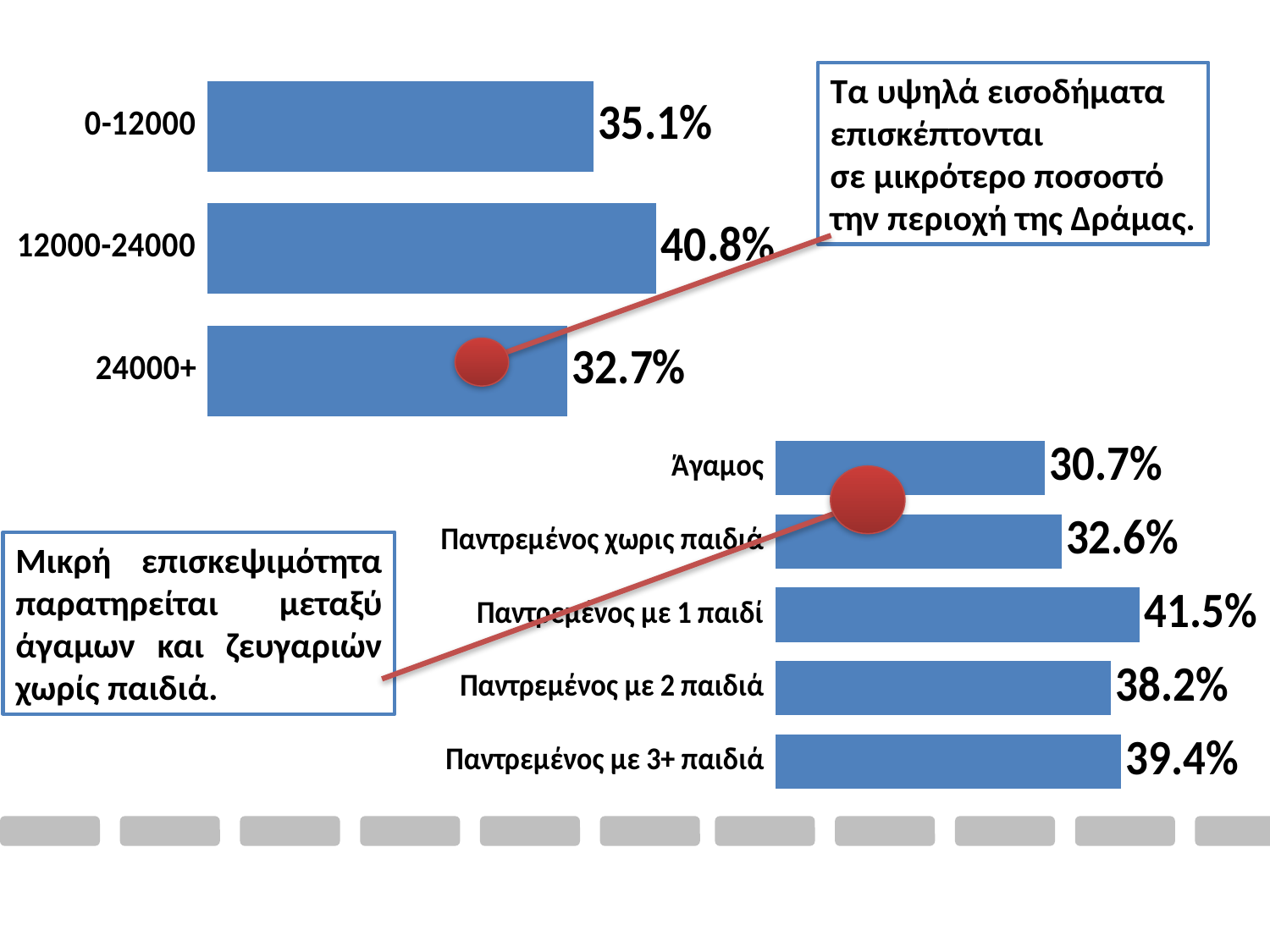
In the bottom-right chart, what is the value for Άγαμος? 30.7% In the bottom-right chart, what is the value for Παντρεμένος με 2 παιδιά? 38.2% In the top-left chart, which income group has the lowest value? 24000+ In the top-left chart, what is the value for the 12000-24000 income group? 40.8% In the bottom-right chart, which is larger: the value for Παντρεμένος με 3+ παιδιά or Παντρεμένος με 2 παιδιά? Παντρεμένος με 3+ παιδιά How many income groups are shown in the top-left chart? 3 In the bottom-right chart, which category has the highest value? Παντρεμένος με 1 παιδί In the top-left chart, what is the value for the 24000+ income group? 32.7% In the top-left chart, what is the difference between the values for 12000-24000 and 0-12000? 5.7% What kind of chart is the bottom-right chart? Bar chart In the bottom-right chart, which category has the lowest value? Άγαμος In the top-left chart, which income group has the highest value? 12000-24000